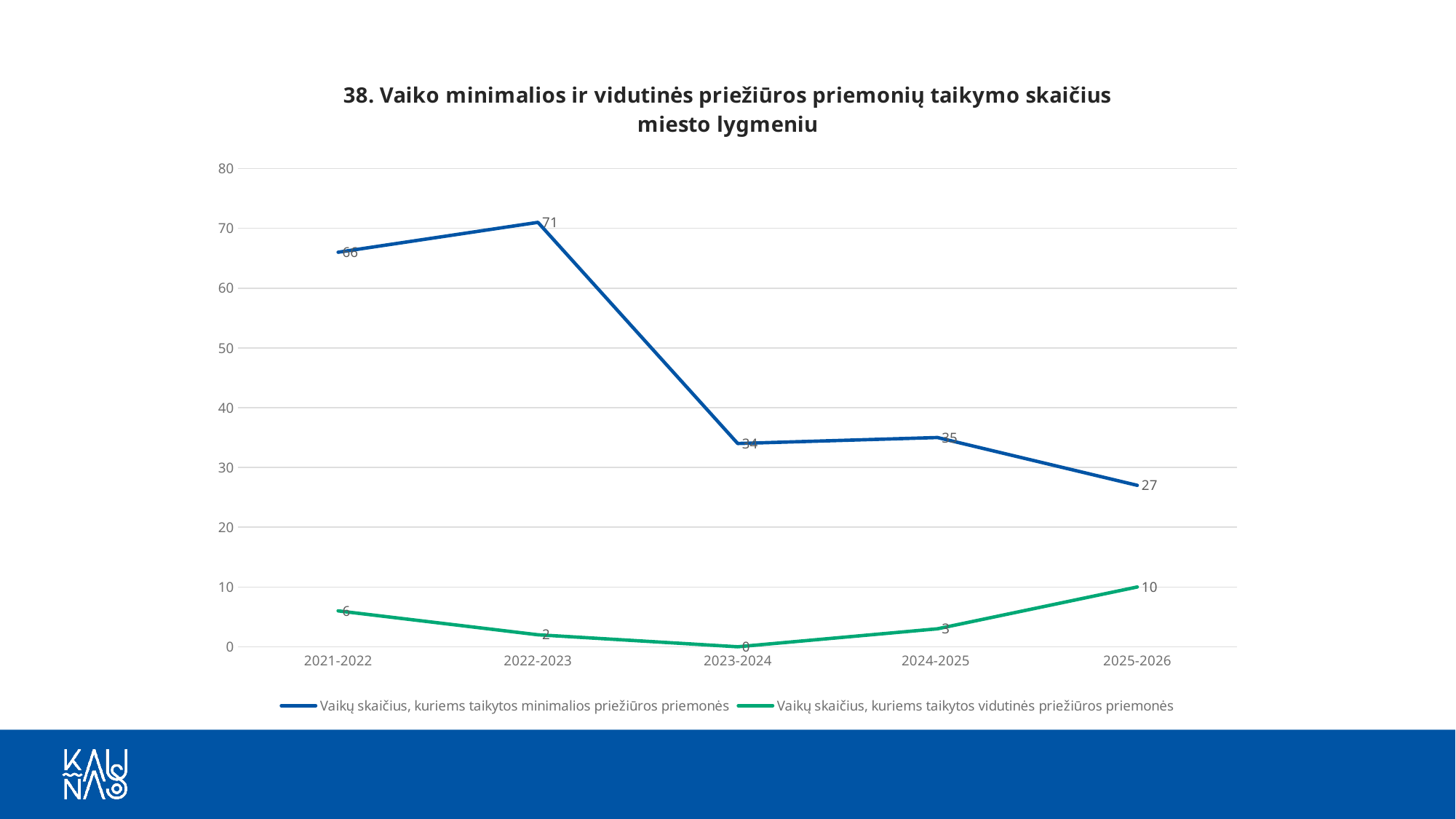
In which period is the value for 'Vaikų skaičius, kuriems taikytos vidutinės priežiūros priemonės' lowest? 2023-2024 How many periods are shown on the x axis? 5 What is the value for 2025-2026 in the series 'Vaikų skaičius, kuriems taikytos vidutinės priežiūros priemonės'? 10 In 2024-2025, which series has the larger value: minimalios priežiūros priemonės or vidutinės priežiūros priemonės? Vaikų skaičius, kuriems taikytos minimalios priežiūros priemonės What is the difference between the 2022-2023 and 2023-2024 values for 'Vaikų skaičius, kuriems taikytos minimalios priežiūros priemonės'? 37 What kind of chart is shown on the slide? line chart How many series does the legend list? 2 What is the value for 2023-2024 in the series 'Vaikų skaičius, kuriems taikytos vidutinės priežiūros priemonės'? 0 What is the value for 2025-2026 in the series 'Vaikų skaičius, kuriems taikytos minimalios priežiūros priemonės'? 27 What is the value for 2022-2023 in the series 'Vaikų skaičius, kuriems taikytos minimalios priežiūros priemonės'? 71 In which period is the value for 'Vaikų skaičius, kuriems taikytos minimalios priežiūros priemonės' highest? 2022-2023 Is the 2021-2022 value for 'Vaikų skaičius, kuriems taikytos minimalios priežiūros priemonės' greater or less than 60? greater